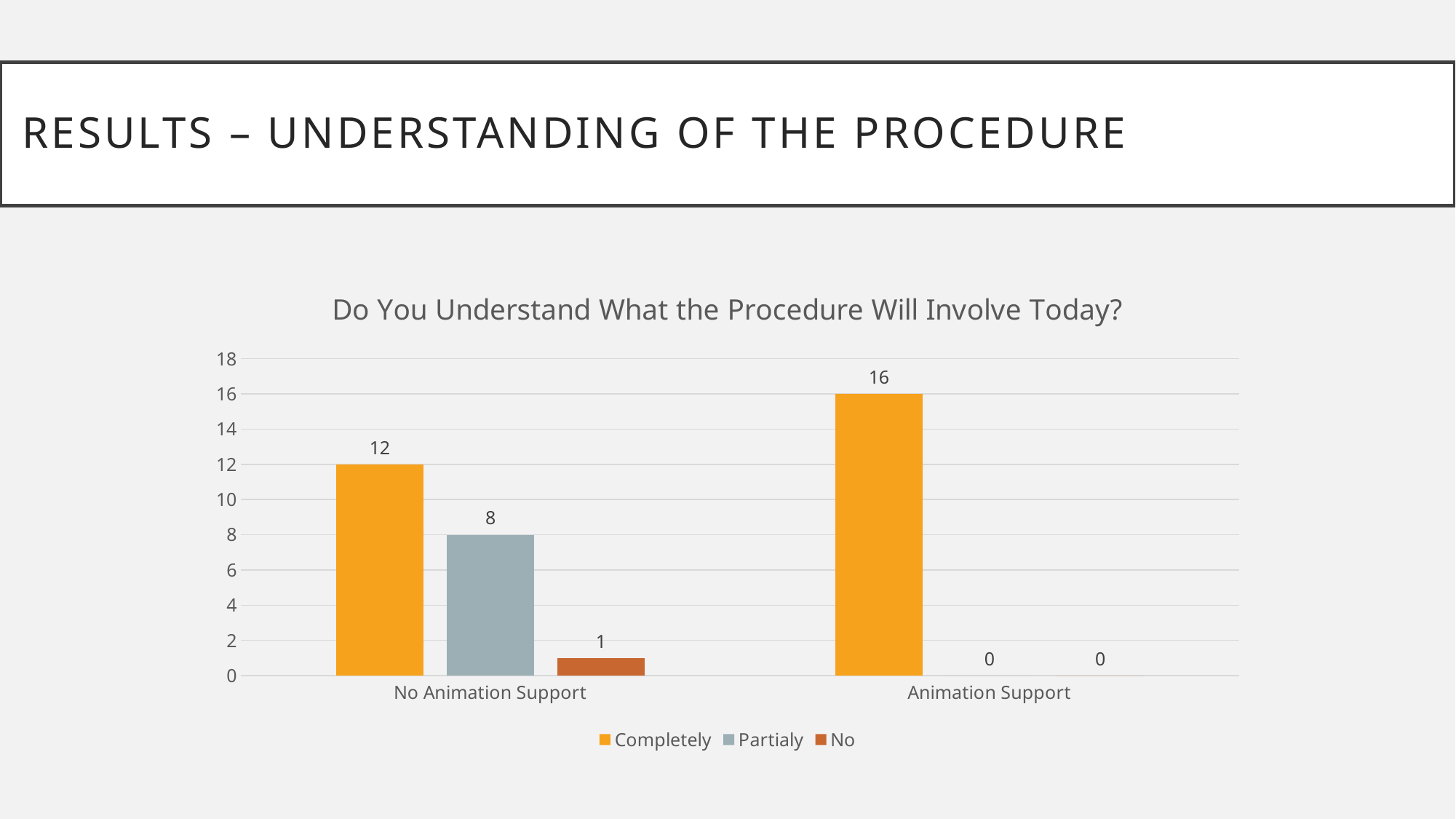
What is the value for Partialy in the No Animation Support group? 8 What is the value for Completely in the Animation Support group? 16 What is the value for No in the No Animation Support group? 1 What is the value for Completely in the No Animation Support group? 12 Which group has the higher value for Completely? Animation Support Which series has the lowest value in the No Animation Support group? No What is the value for Partialy in the Animation Support group? 0 What is the title of the chart? Do You Understand What the Procedure Will Involve Today? What is the difference between the Completely values for Animation Support and No Animation Support? 4 How many series does the legend list? 3 What kind of chart is shown? Bar chart How many category groups are shown on the x axis? 2